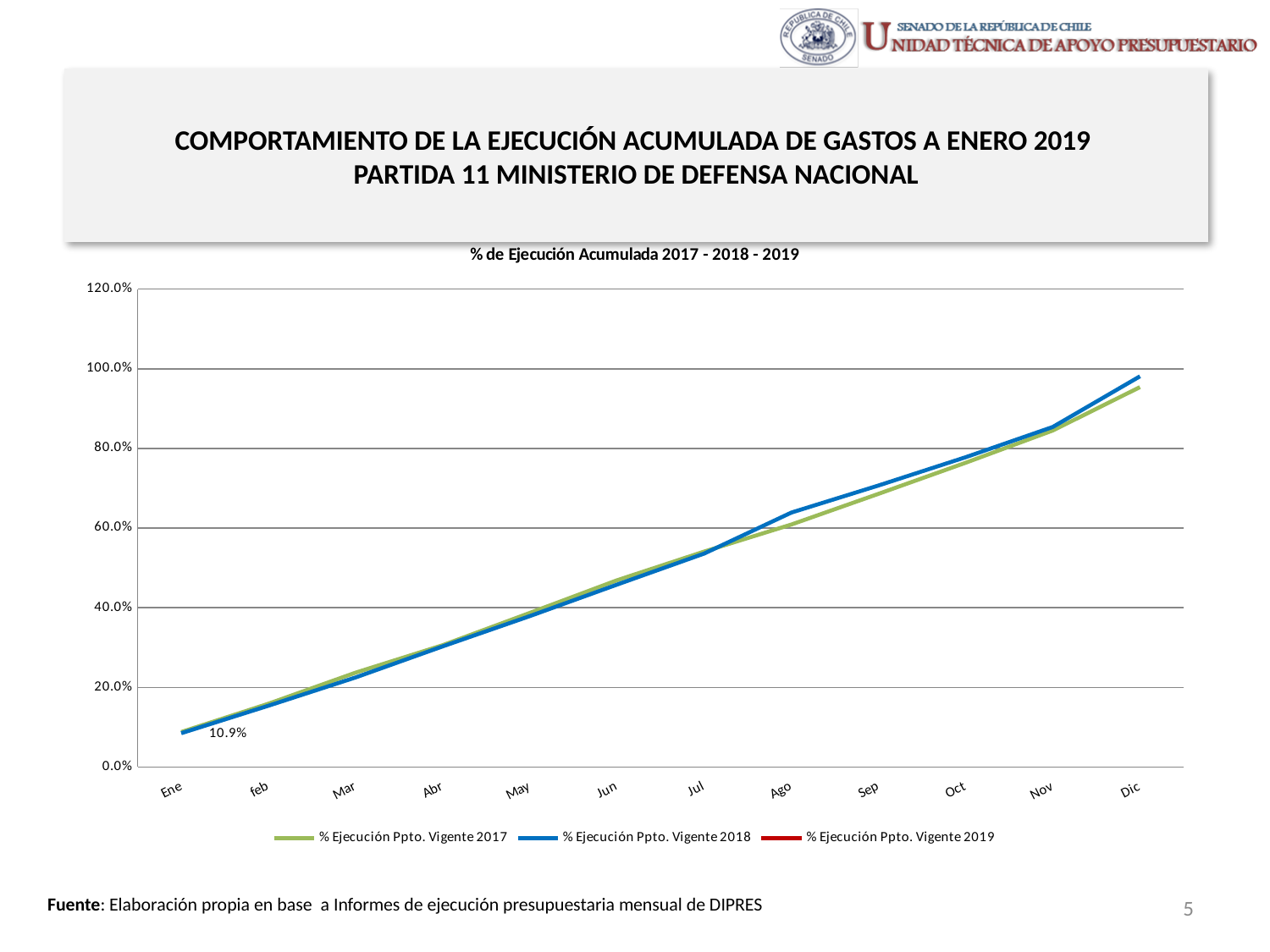
In which month is the value for % Ejecución Ppto. Vigente 2018 highest? Dic What is the title of the chart? % de Ejecución Acumulada 2017 - 2018 - 2019 What kind of chart is shown on the slide? line chart At Dic, which series has the larger value: % Ejecución Ppto. Vigente 2017 or % Ejecución Ppto. Vigente 2018? % Ejecución Ppto. Vigente 2018 What value is printed as a data label at Ene on the chart? 10.9% Is the value for % Ejecución Ppto. Vigente 2017 at Jul greater or less than 60.0%? less What colour is the line for % Ejecución Ppto. Vigente 2018 in the chart? blue Is the value for % Ejecución Ppto. Vigente 2018 at Dic greater or less than 80.0%? greater How many series does the chart legend list? 3 In which month is the value for % Ejecución Ppto. Vigente 2017 lowest? Ene How many months are shown along the x axis of the chart? 12 Do the values for % Ejecución Ppto. Vigente 2018 rise or fall from Ene to Dic? rise